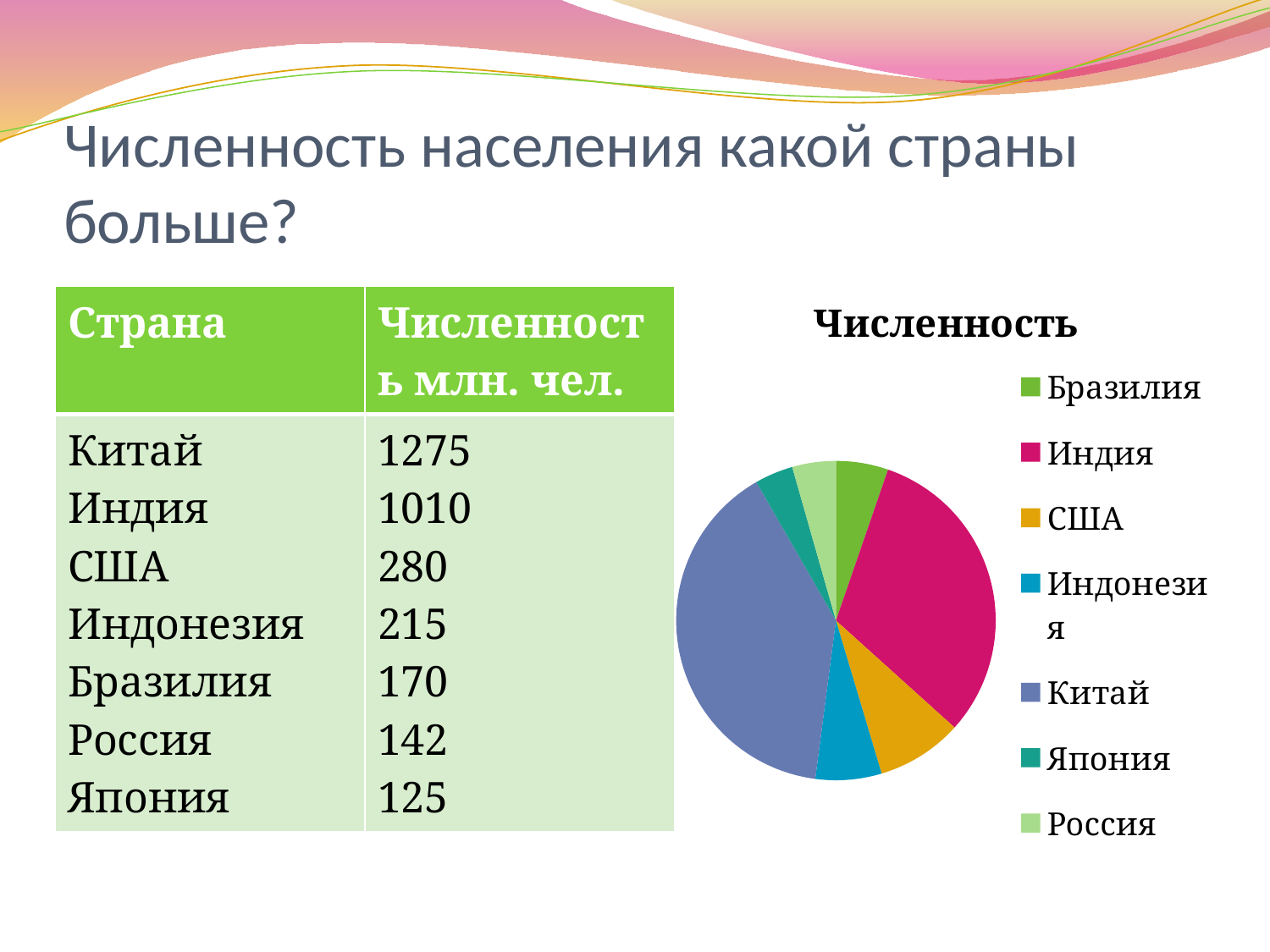
Which has the larger slice, Бразилия or Индонезия? Индонезия What kind of chart is shown on the slide? pie chart How many countries (slices) does the pie chart show? 7 What is the difference between the population values of США and Япония, in млн. чел.? 155 What is the title of the chart? Численность Which country has the smallest slice in the pie chart? Япония Which country has the largest slice in the pie chart? Китай What is the population value for Россия, in млн. чел.? 142 Which has the larger slice, Индия or США? Индия What is the population value for Индонезия, in млн. чел.? 215 What is the difference between the population values of Китай and Индия, in млн. чел.? 265 What is the population value for Китай, in млн. чел.? 1275